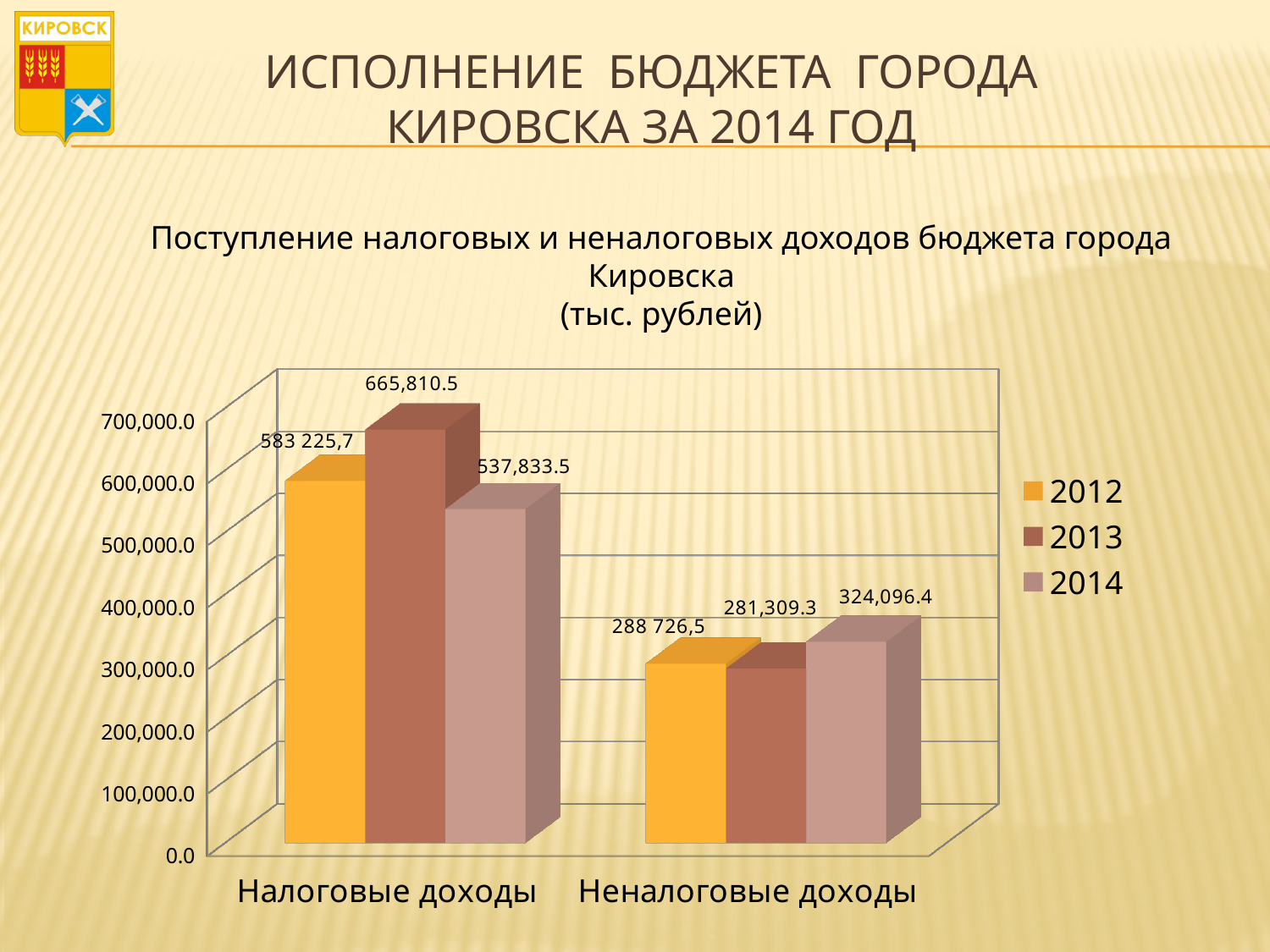
Which year has the highest value for Налоговые доходы? 2013 What is the value for Неналоговые доходы in 2014? 324,096.4 How many categories are shown on the x axis? 2 What is the value for Налоговые доходы in 2013? 665,810.5 What is the value for Неналоговые доходы in 2013? 281,309.3 Which is larger: Неналоговые доходы in 2014 or in 2013? 2014 Which year has the lowest value for Неналоговые доходы? 2013 What is the value for Налоговые доходы in 2014? 537,833.5 Which legend entry is shown in orange? 2012 What is the difference between the 2013 and 2014 values for Налоговые доходы? 127,977.0 What kind of chart is shown on the slide? bar chart How many series does the legend list? 3